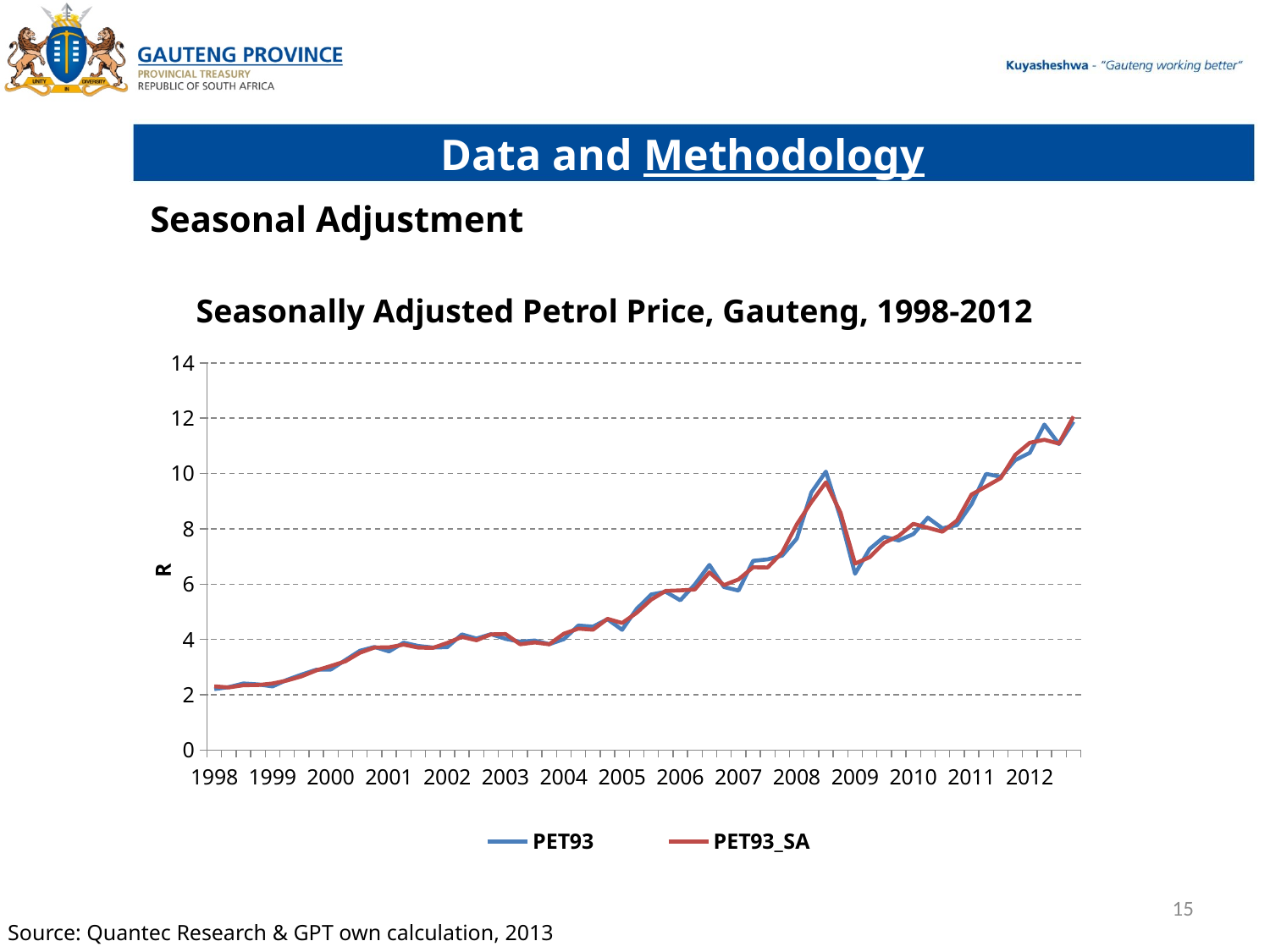
Is the PET93 value at the end of 2012 greater or less than 10? greater What are the two series named in the legend? PET93 and PET93_SA Which is larger for PET93: the value at the start of 1998 or the value at the end of 2012? end of 2012 How many year labels are shown on the x axis? 15 Is the PET93_SA value at the start of 2005 greater or less than 6? less Is the PET93_SA value at the start of 1998 greater or less than 4? less What kind of chart is shown on the slide? line chart What is the title of the chart? Seasonally Adjusted Petrol Price, Gauteng, 1998-2012 Overall, do the petrol price values rise or fall from 1998 to 2012? rise How many series does the legend list? 2 Which is larger for PET93: the peak in 2008 or the value at the end of 2012? end of 2012